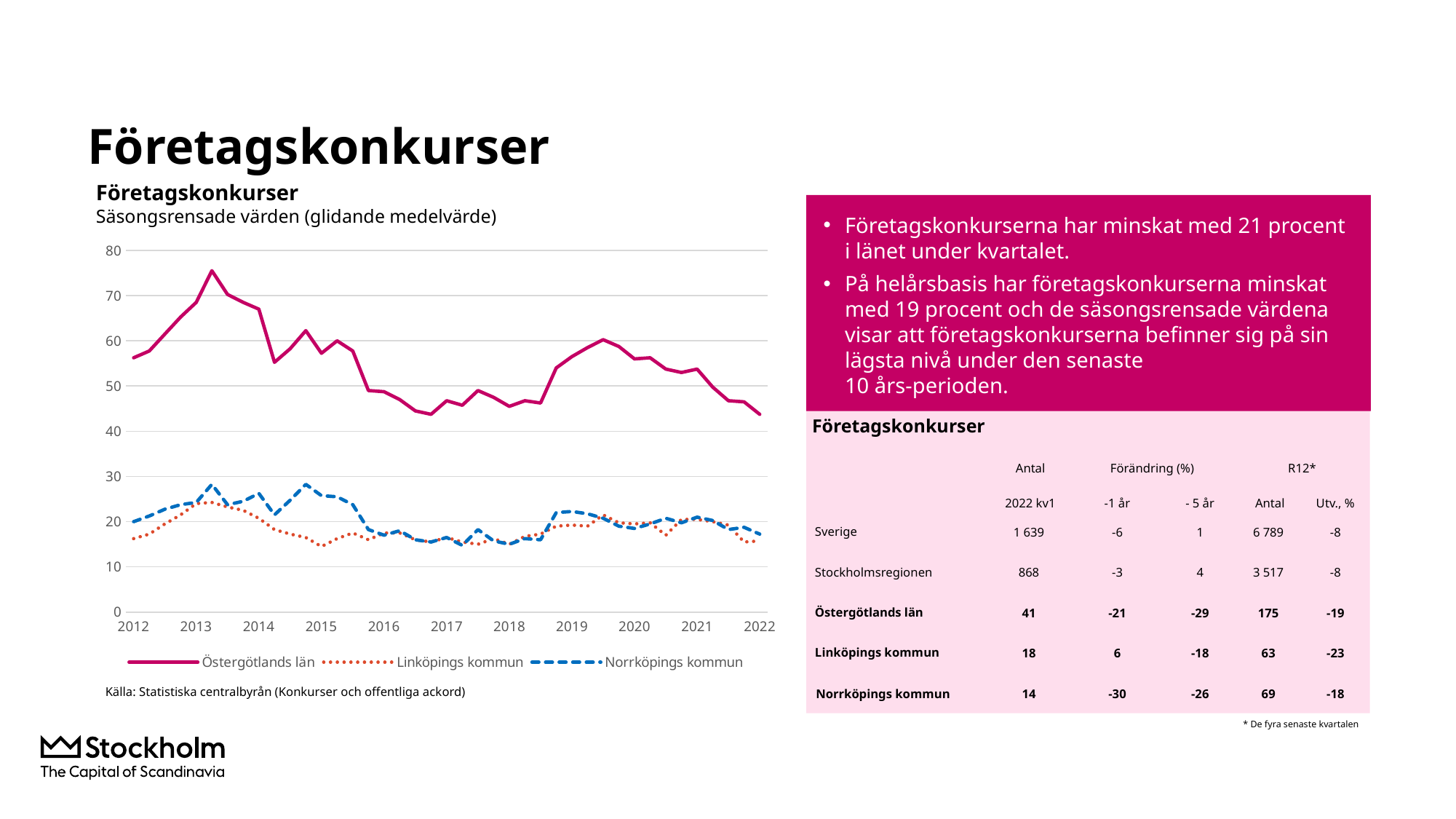
Does the Östergötlands län line rise or fall from 2019 to 2022? fall Is the peak value for Östergötlands län in 2013 greater or less than 70? greater Which series has the highest values throughout the chart? Östergötlands län Is the value for Norrköpings kommun at 2022 greater or less than 20? less What kind of chart is shown on the slide? line chart How many series does the chart's legend list? 3 At 2012, which is larger: the value for Östergötlands län or for Linköpings kommun? Östergötlands län How many year labels are shown on the x axis? 11 Is the value for Östergötlands län at 2022 greater or less than 50? less Which series are listed in the chart's legend? Östergötlands län, Linköpings kommun, Norrköpings kommun